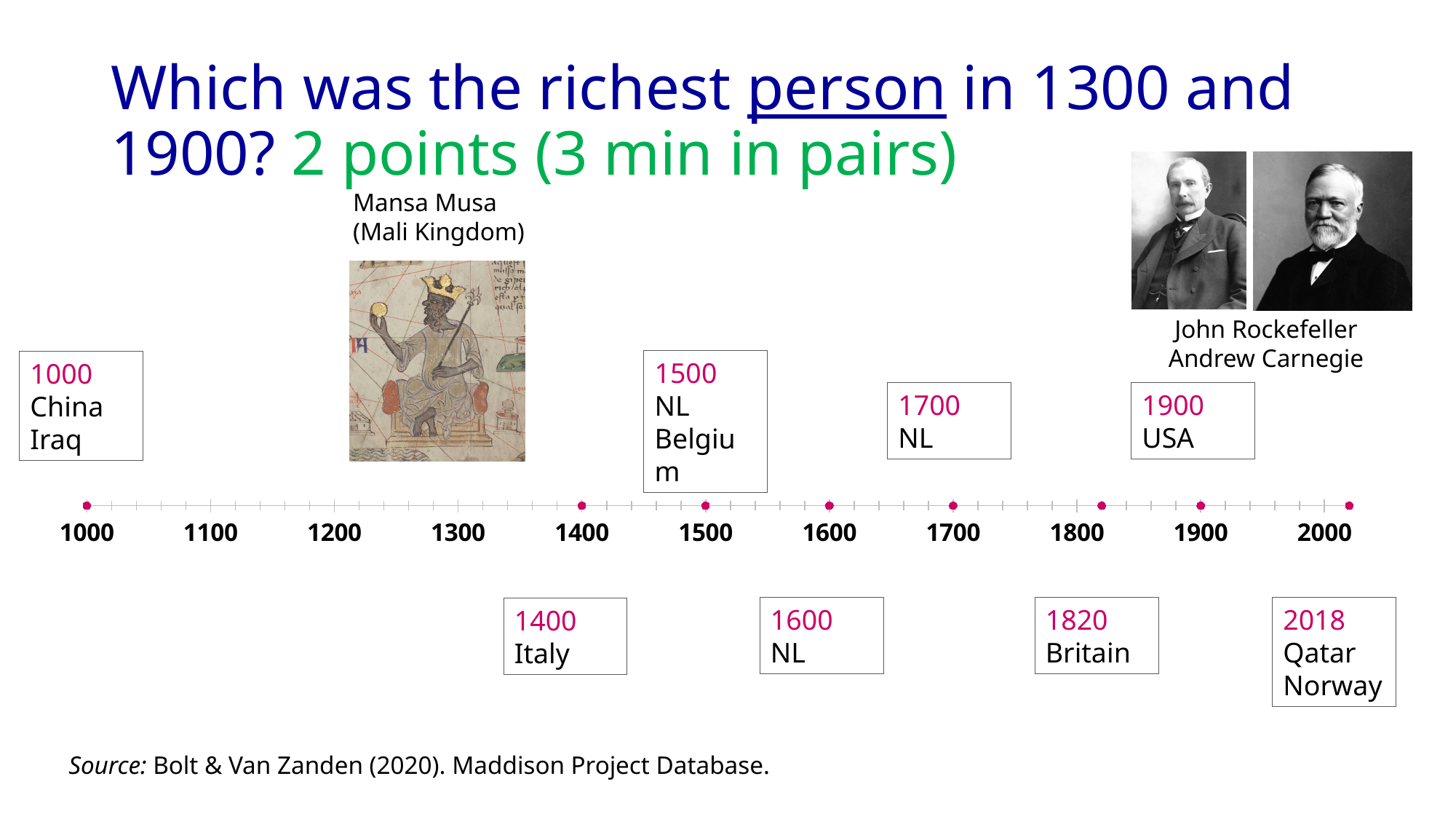
Which person is pictured above the timeline near the 1300 mark? Mansa Musa (Mali Kingdom) Which country is labelled at the 1400 marker on the timeline? Italy How many marked points are there on the timeline? 8 Which countries are labelled at the 1500 marker on the timeline? NL and Belgium What kind of chart is shown on the slide? A timeline How many years separate the 1820 marker and the 1900 marker on the timeline? 80 What is the earliest year marked on the timeline? 1000 What is the latest year marked on the timeline? 2018 Which country is labelled at the 1820 marker on the timeline? Britain Which country is labelled at the 1900 marker on the timeline? USA Which countries are labelled at the 1000 marker on the timeline? China and Iraq Which countries are labelled at the 2018 marker on the timeline? Qatar and Norway